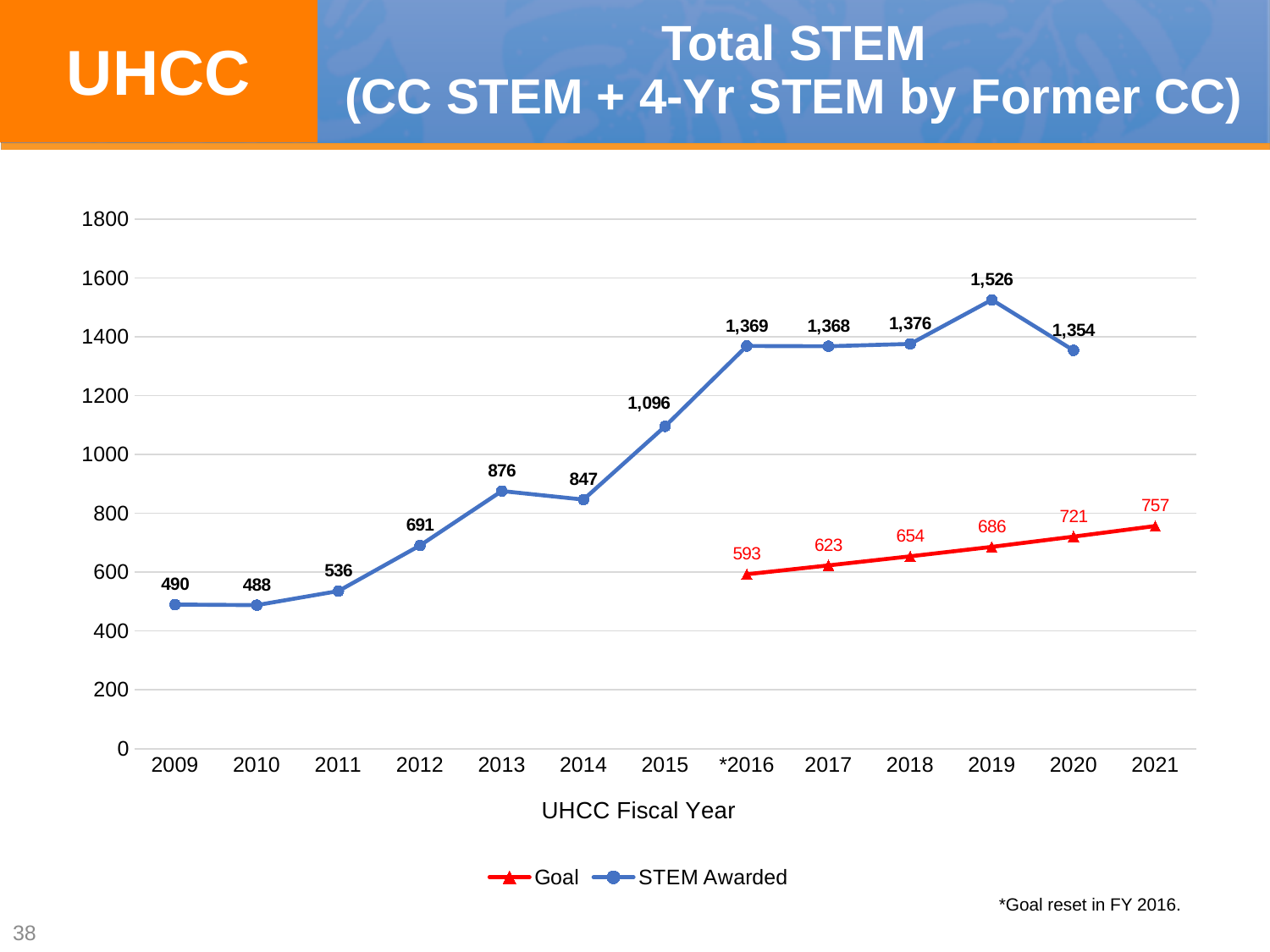
What kind of chart is shown on the slide? Line chart What is the STEM Awarded value for 2009? 490 How many years are shown on the x axis? 13 Is the STEM Awarded value for 2015 greater or less than 1000? greater What is the Goal value for 2021? 757 How many series does the legend list? 2 What is the difference between the STEM Awarded value and the Goal value in 2020? 633 In which year is the STEM Awarded value lowest? 2010 What is the STEM Awarded value for 2019? 1,526 In which year is the STEM Awarded value highest? 2019 Does the Goal series rise or fall from 2016 to 2021? Rise Which is larger, the STEM Awarded value for 2013 or for 2014? 2013